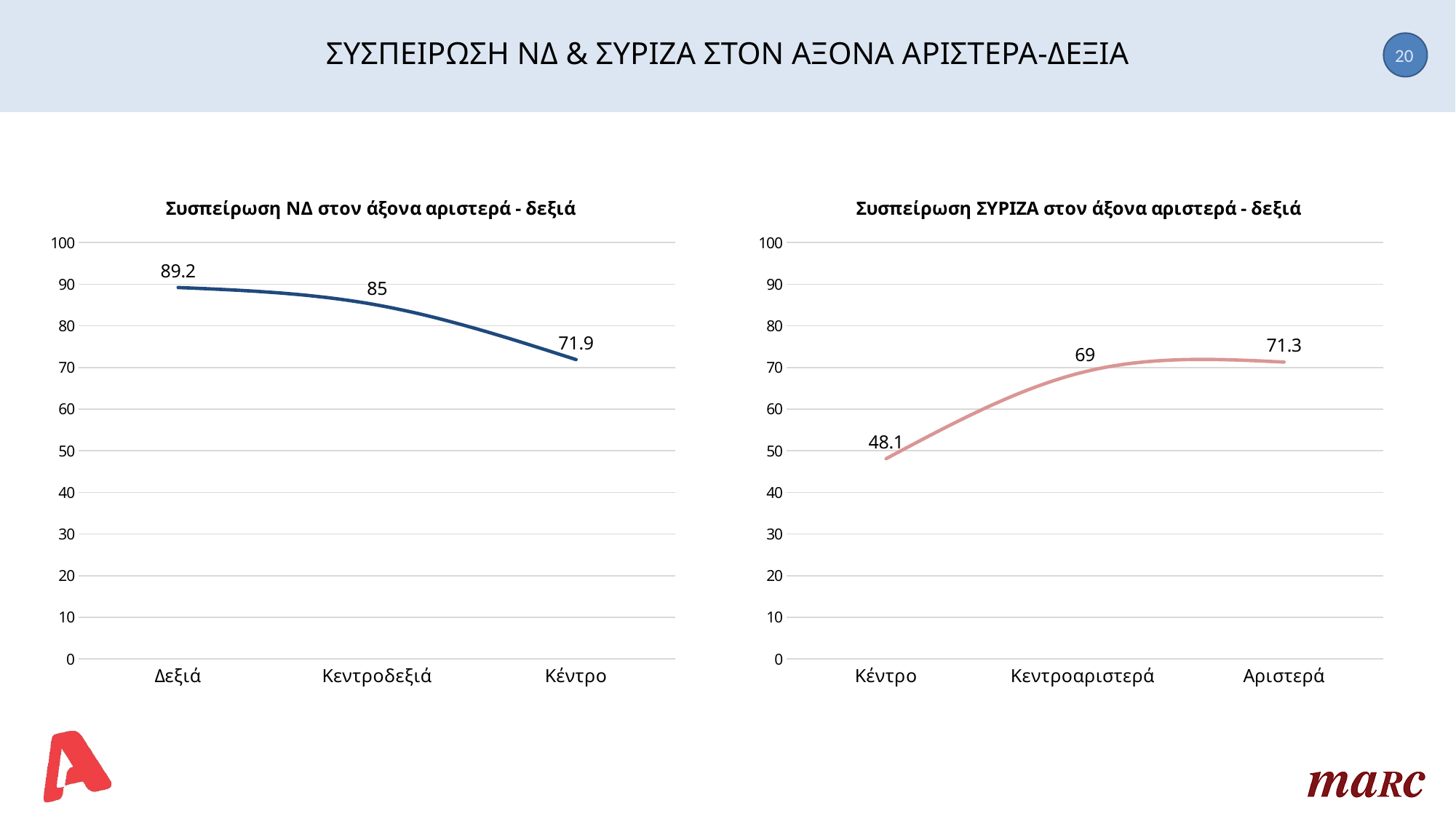
In the right chart (Συσπείρωση ΣΥΡΙΖΑ στον άξονα αριστερά - δεξιά), which category has the highest value? Αριστερά Which is larger: the value for Κέντρο in the left chart (ΝΔ) or the value for Κέντρο in the right chart (ΣΥΡΙΖΑ)? Κέντρο in the left chart (ΝΔ) In the left chart (Συσπείρωση ΝΔ στον άξονα αριστερά - δεξιά), which category has the lowest value? Κέντρο In the right chart (Συσπείρωση ΣΥΡΙΖΑ στον άξονα αριστερά - δεξιά), do the values rise or fall from left to right along the x axis? rise In the left chart (Συσπείρωση ΝΔ στον άξονα αριστερά - δεξιά), what is the value for Δεξιά? 89.2 In the left chart (Συσπείρωση ΝΔ στον άξονα αριστερά - δεξιά), what is the difference between the values for Δεξιά and Κέντρο? 17.3 In the left chart (Συσπείρωση ΝΔ στον άξονα αριστερά - δεξιά), what is the value for Κεντροδεξιά? 85 In the right chart (Συσπείρωση ΣΥΡΙΖΑ στον άξονα αριστερά - δεξιά), what is the value for Αριστερά? 71.3 In the right chart (Συσπείρωση ΣΥΡΙΖΑ στον άξονα αριστερά - δεξιά), what is the difference between the values for Κεντροαριστερά and Κέντρο? 20.9 What kind of chart is the left chart (Συσπείρωση ΝΔ στον άξονα αριστερά - δεξιά)? line chart In the right chart (Συσπείρωση ΣΥΡΙΖΑ στον άξονα αριστερά - δεξιά), what is the value for Κέντρο? 48.1 In the left chart (Συσπείρωση ΝΔ στον άξονα αριστερά - δεξιά), what is the value for Κέντρο? 71.9